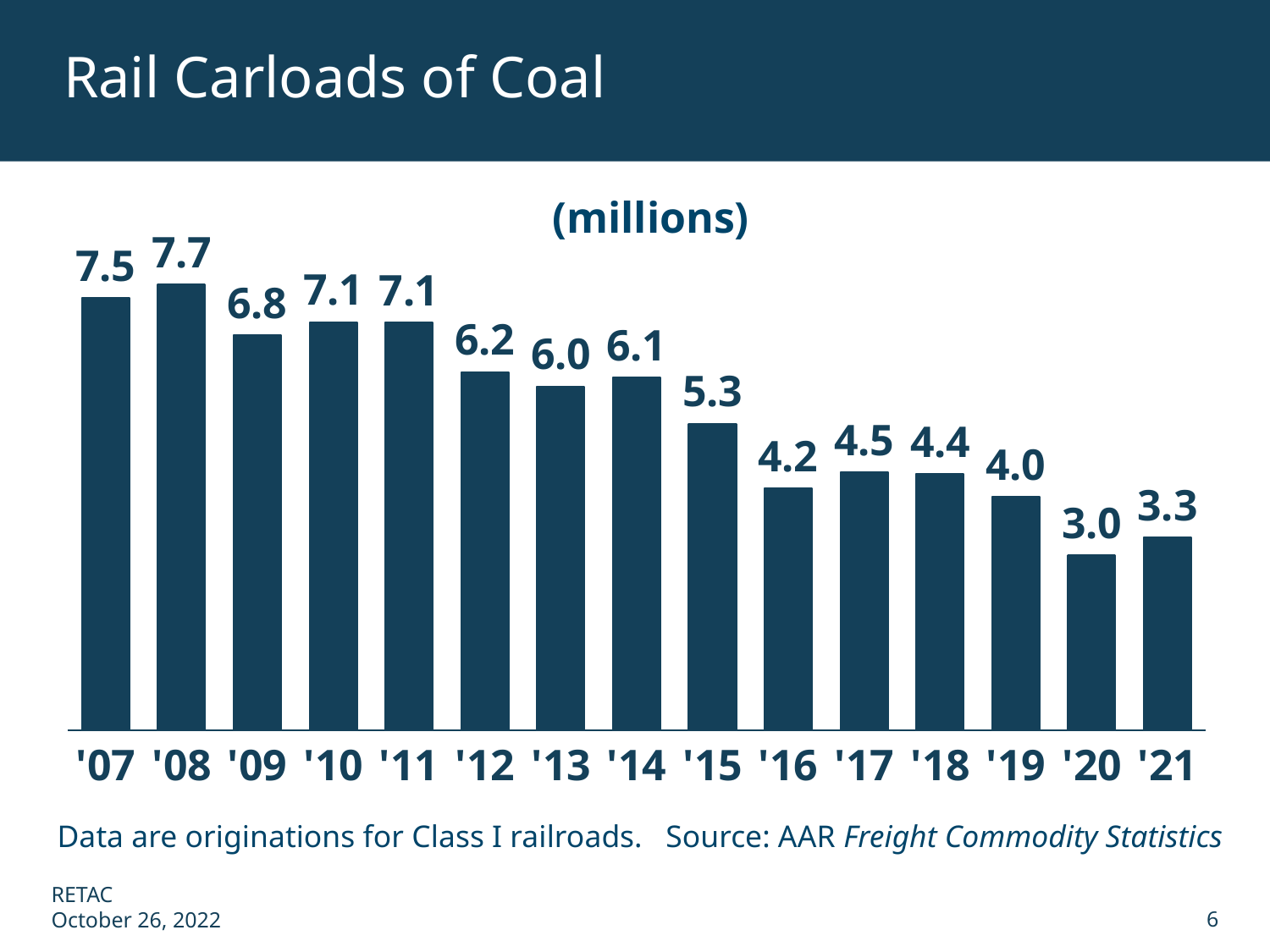
What is the value for '08? 7.7 How many years are shown on the chart? 15 What is the difference between the values for '15 and '16? 1.1 What is the title of the chart? Rail Carloads of Coal What is the value for '15? 5.3 What kind of chart is this? Bar chart Which year has the lowest value? '20 What is the difference between the values for '07 and '21? 4.2 Which year has the highest value? '08 Do the values generally rise or fall from '07 to '21? Fall Which is larger, the value for '17 or the value for '19? '17 What is the value for '20? 3.0